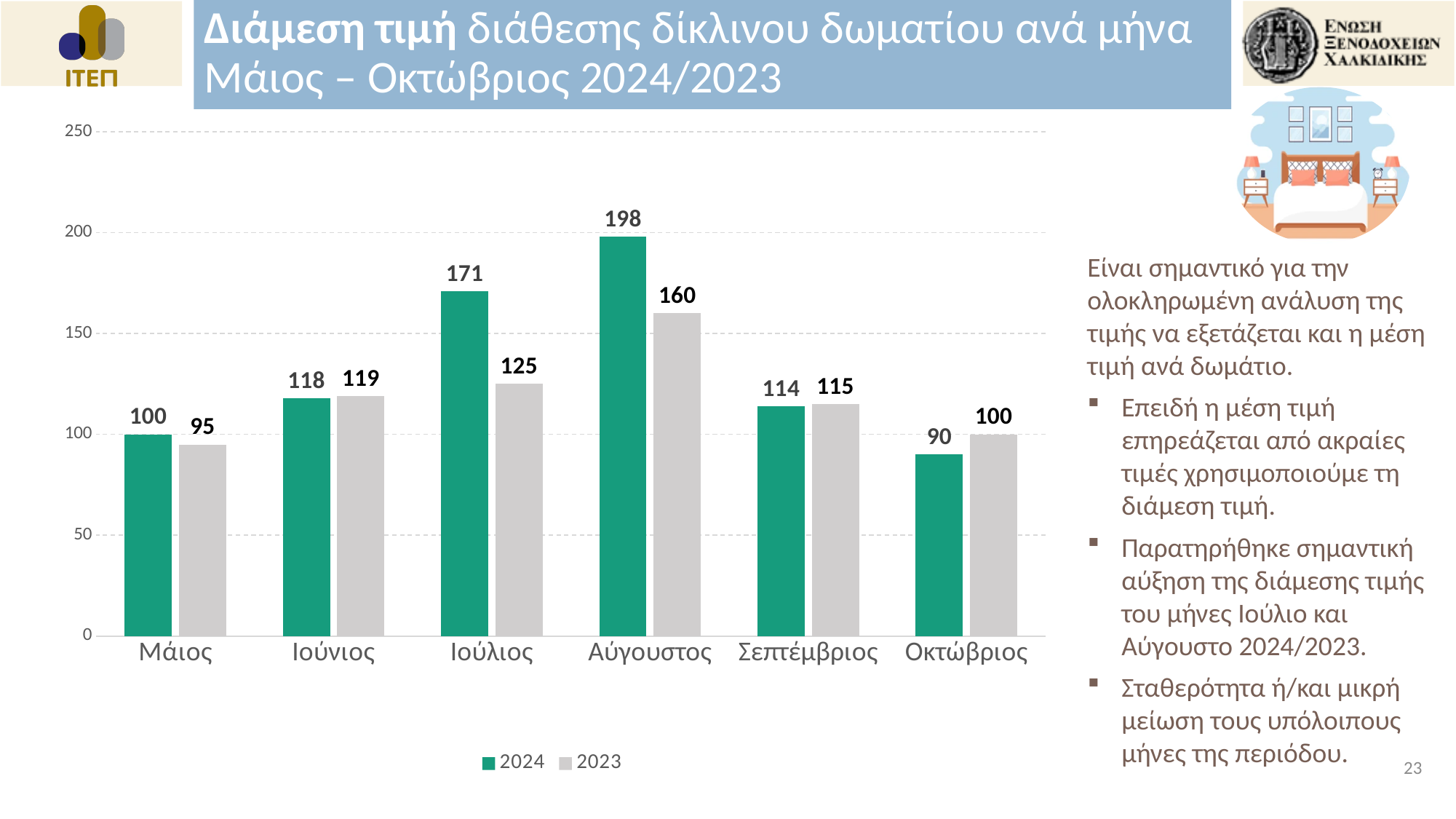
What is the 2023 value for Ιούλιος? 125 Which month has the lowest 2023 value? Μάιος What is the difference between the 2024 and 2023 values for Αύγουστος? 38 Which month has the highest 2024 value? Αύγουστος What is the 2024 value for Αύγουστος? 198 What is the difference between the 2024 and 2023 values for Ιούλιος? 46 How many months are shown on the x axis? 6 Which is larger for Οκτώβριος, the 2024 value or the 2023 value? 2023 What is the 2024 value for Οκτώβριος? 90 How many series does the legend list? 2 What kind of chart is shown on the slide? Bar chart Which colour represents the 2024 series? Green